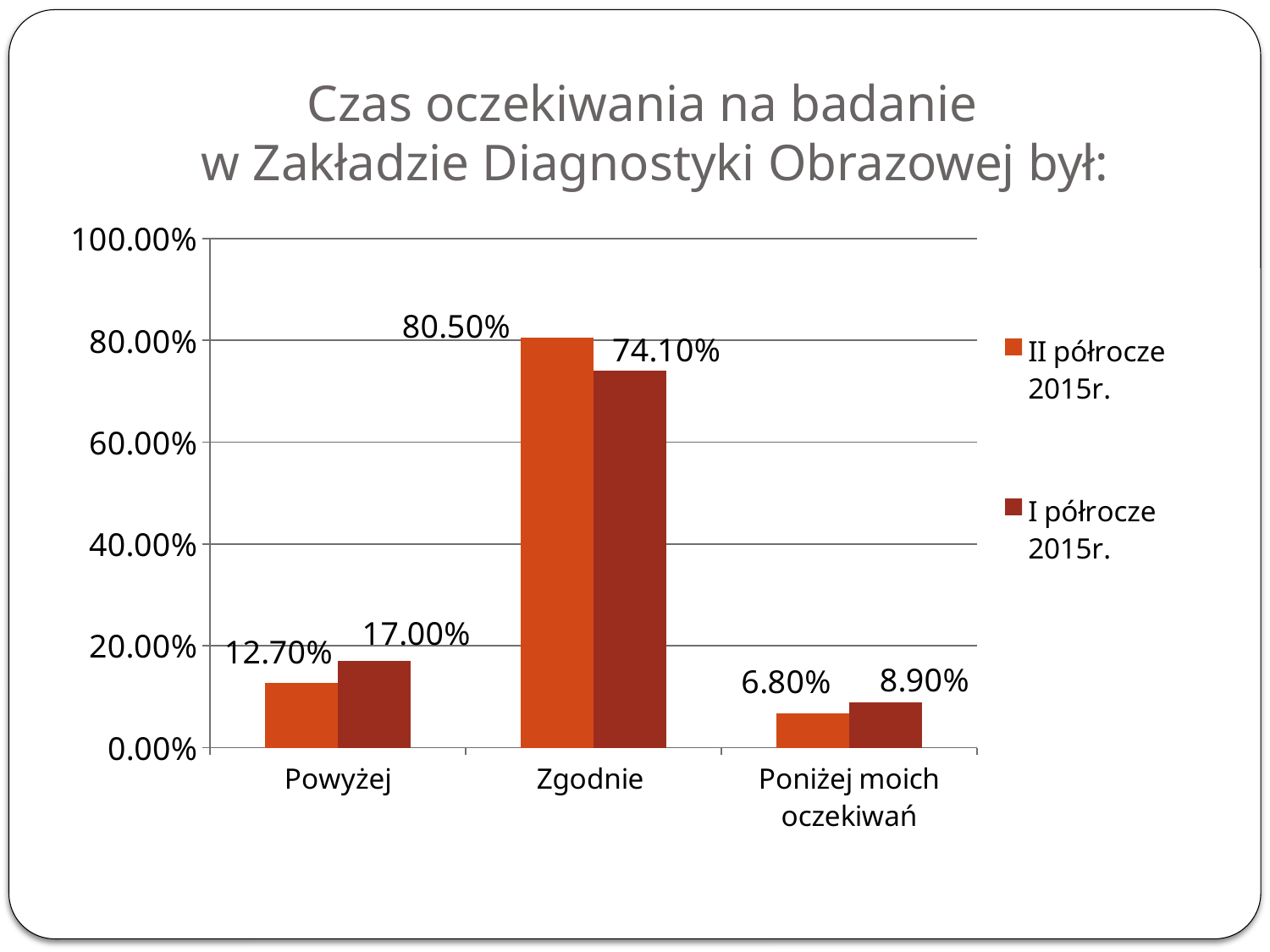
Which category has the lowest value in the II półrocze 2015r. series? Poniżej moich oczekiwań For Powyżej, which series has the larger value: II półrocze 2015r. or I półrocze 2015r.? I półrocze 2015r. What is the value for Powyżej in the I półrocze 2015r. series? 17.00% How many series does the legend list? 2 Is the value for Zgodnie in the I półrocze 2015r. series greater or less than 60.00%? greater What kind of chart is shown on the slide? bar chart What is the value for Poniżej moich oczekiwań in the II półrocze 2015r. series? 6.80% Which category has the highest value in the I półrocze 2015r. series? Zgodnie What is the title of the chart? Czas oczekiwania na badanie w Zakładzie Diagnostyki Obrazowej był: What is the value for Zgodnie in the II półrocze 2015r. series? 80.50% What is the difference between the II półrocze 2015r. and I półrocze 2015r. values for Zgodnie? 6.40% How many categories are shown on the x axis? 3